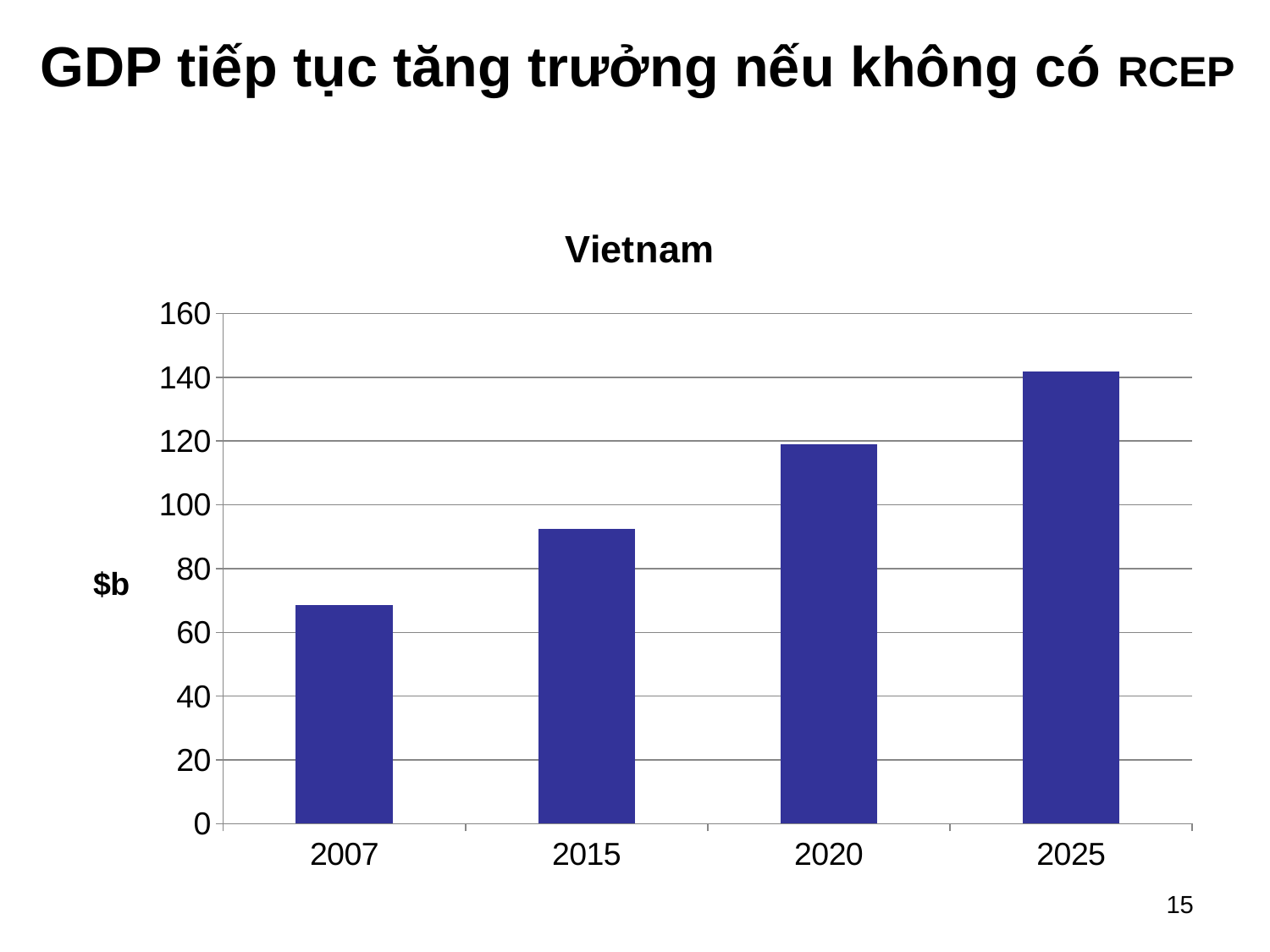
What is the title of the chart? Vietnam Is the value for 2015 greater or less than 80? greater What is the label on the vertical axis of the chart? $b Do the values rise or fall from 2007 to 2025? rise Which is larger, the value for 2015 or the value for 2020? 2020 Is the value for 2025 greater or less than 120? greater What kind of chart is shown on the slide? bar chart Is the value for 2007 greater or less than 80? less How many bars (years) are shown in the chart? 4 Which year has the highest value in the chart? 2025 Which year has the lowest value in the chart? 2007